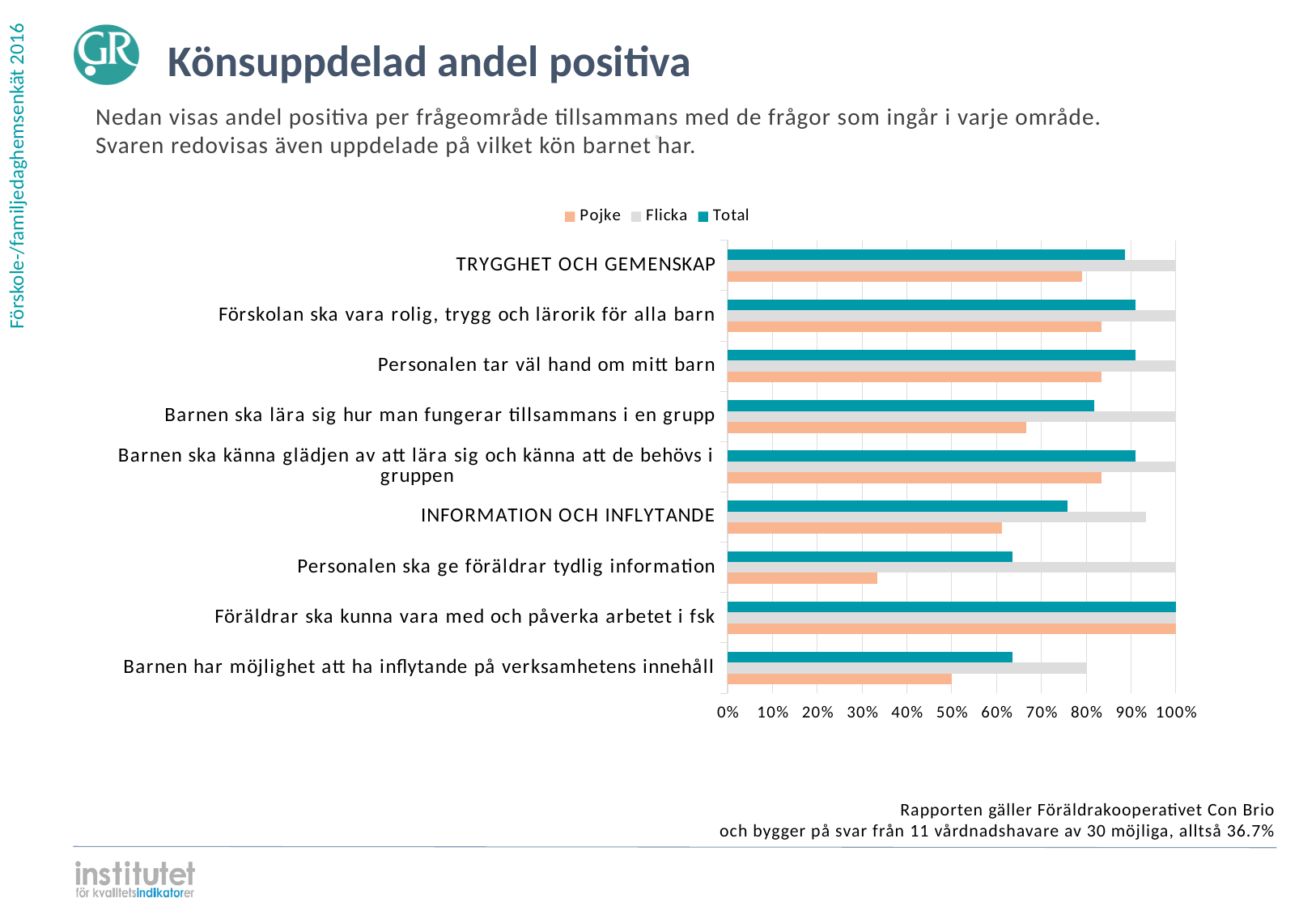
How many series does the legend list? 3 Is the Flicka value for 'INFORMATION OCH INFLYTANDE' greater or less than 80%? greater Which series is shown in teal in the legend? Total What kind of chart is shown on the slide? bar chart What is the Total value for 'Föräldrar ska kunna vara med och påverka arbetet i fsk'? 100% For 'Barnen har möjlighet att ha inflytande på verksamhetens innehåll', which is larger: the Pojke value or the Flicka value? Flicka Is the Pojke value for 'Personalen ska ge föräldrar tydlig information' greater or less than 40%? less How many categories are plotted on the y axis of the chart? 9 What is the Flicka value for 'TRYGGHET OCH GEMENSKAP'? 100% Is the Pojke value for 'Barnen har möjlighet att ha inflytande på verksamhetens innehåll' greater or less than 60%? less Which category has the lowest Pojke value? Personalen ska ge föräldrar tydlig information